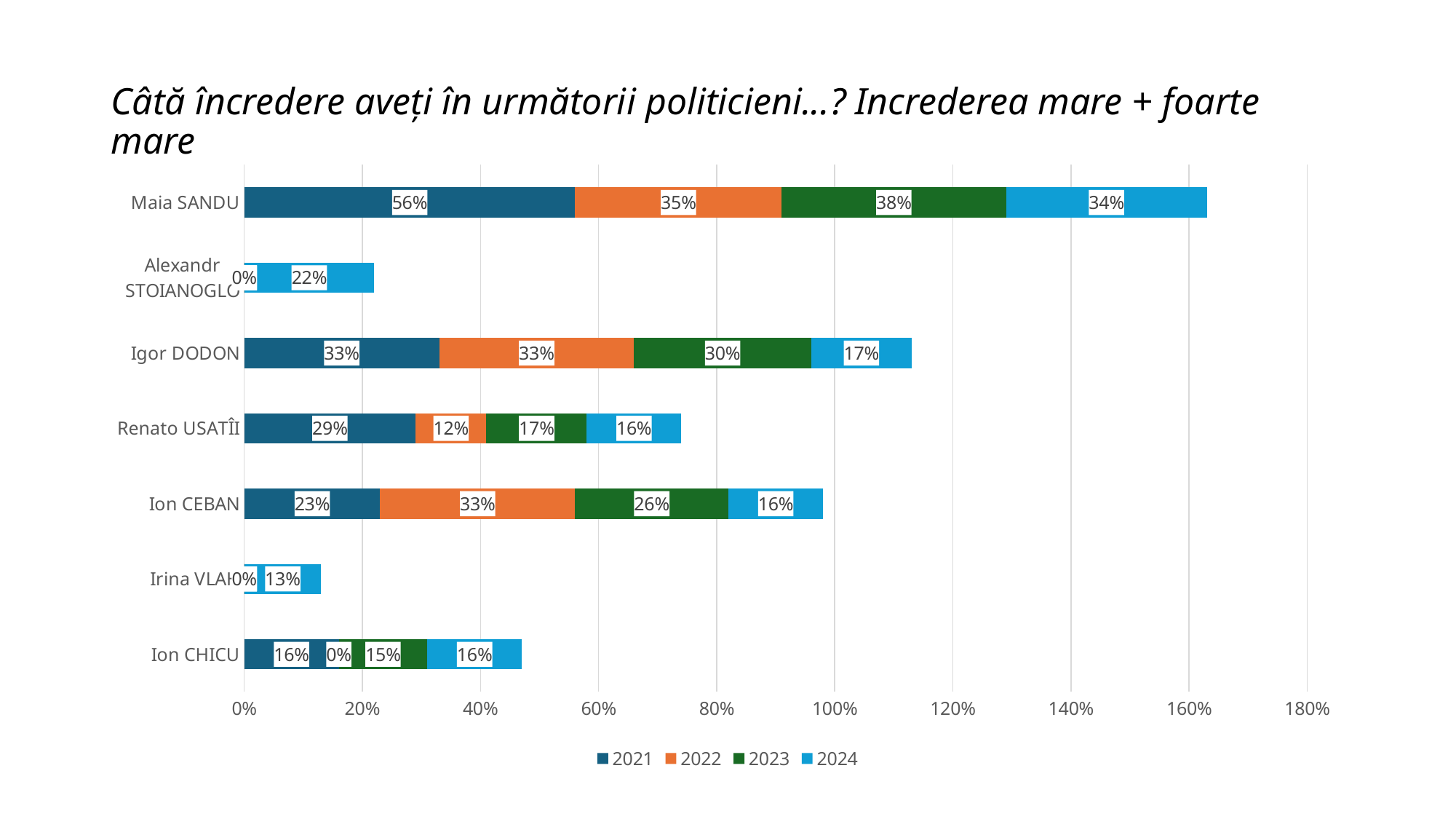
How many politicians are shown on the chart? 7 What is the 2023 value for Igor DODON? 30% What is the difference between Maia SANDU's 2021 value and her 2024 value? 22 percentage points What is the total of the stacked bar for Igor DODON? 113% Which is larger: the 2021 value for Renato USATÎI or the 2021 value for Ion CEBAN? Renato USATÎI Which politician has the longest stacked bar overall? Maia SANDU What is the 2022 value for Ion CHICU? 0% What is the 2024 value for Alexandr STOIANOGLO? 22% What is the 2021 value for Maia SANDU? 56% How many series does the legend list? 4 What is the 2022 value for Ion CEBAN? 33% What kind of chart is shown on the slide? Stacked bar chart